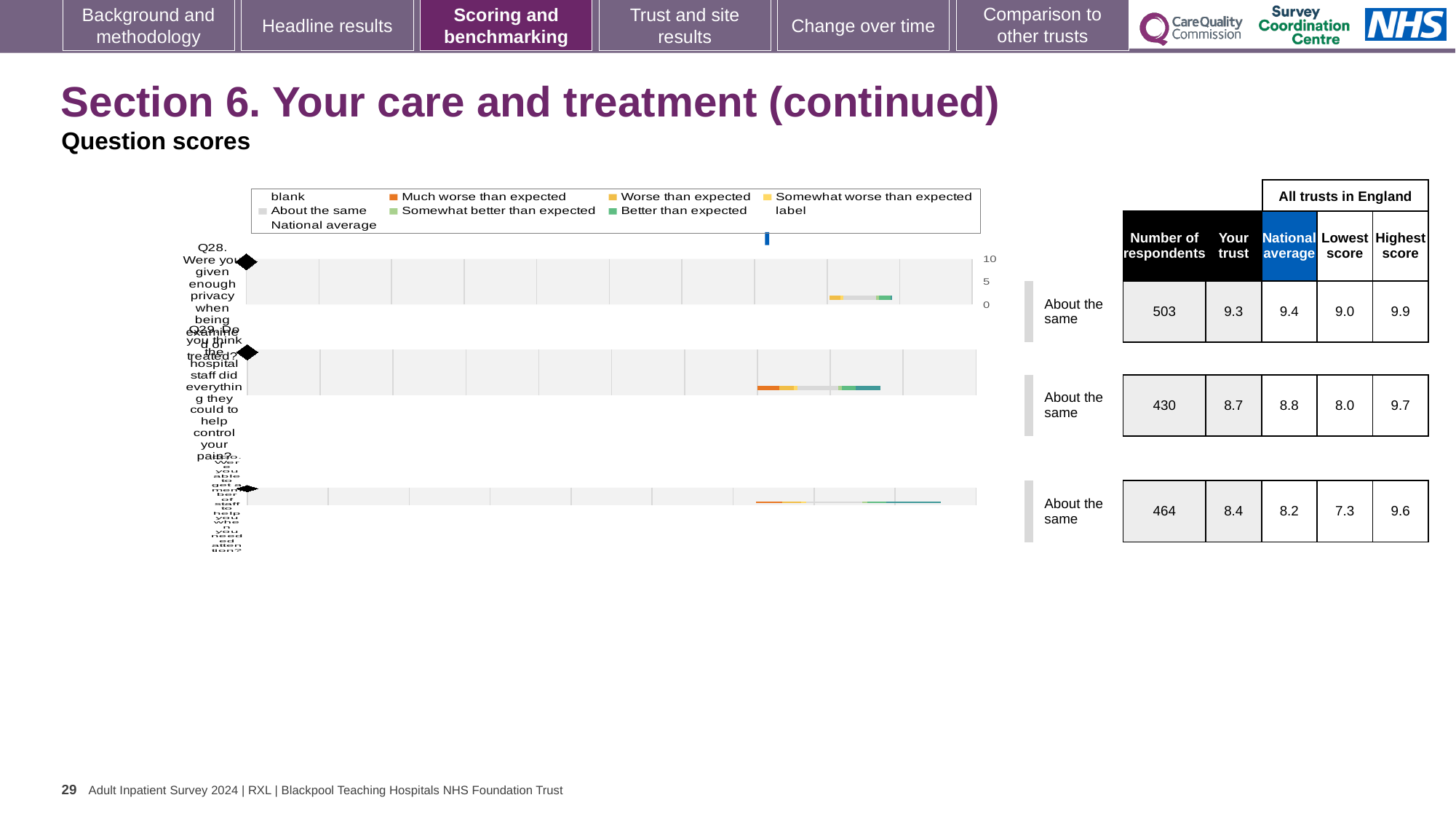
For Q29, which is larger: the 'Your trust' score or the national average? National average How many respondents answered Q28? 503 What is the national average score for Q29 (Do you think hospital staff did everything they could to help control your pain?)? 8.8 Which question row has the lowest 'Lowest score' value? Q30 (the third row) Which question row has the highest 'Your trust' score? Q28 For the third question row (Q30), how much higher is the 'Your trust' score than the national average? 0.2 What is the 'Your trust' score for Q28 (Were you given enough privacy when being examined or treated?)? 9.3 What kind of chart is used to show the question scores? Bar chart How many question rows are plotted on the chart? 3 What is the difference between the highest score and the lowest score for Q28? 0.9 What benchmark category is shown for Q28? About the same What is the highest score among all trusts in England for the third question row (Q30)? 9.6